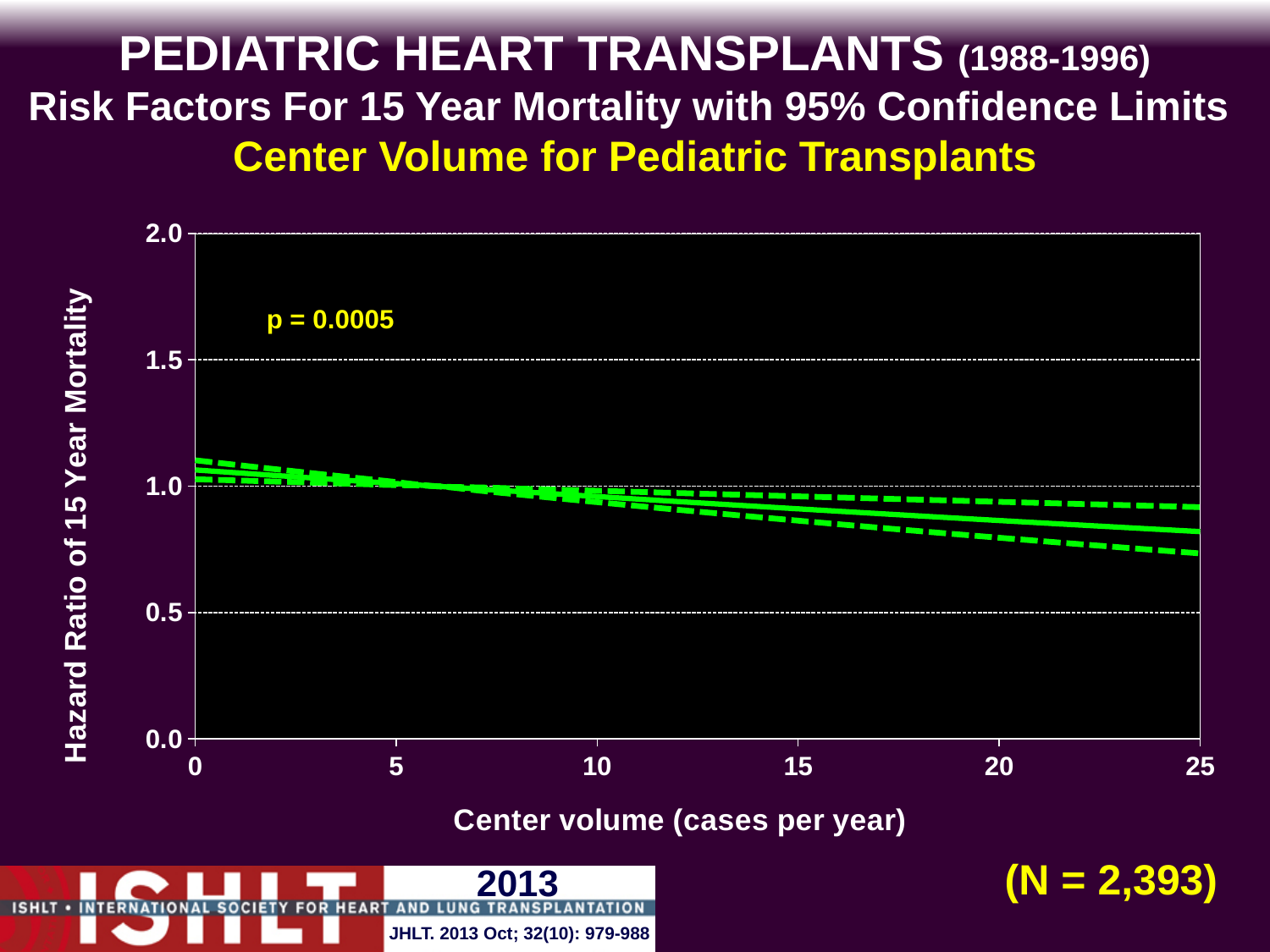
Is the hazard ratio of the solid line at a center volume of 5 cases per year greater or less than 1.5? less Is the hazard ratio of the solid line at a center volume of 0 cases per year greater or less than 1.0? greater Is the hazard ratio of the solid line at a center volume of 20 cases per year greater or less than 0.5? greater Does the hazard ratio rise or fall as center volume increases from 0 to 25 cases per year? fall Is the hazard ratio of the solid line higher at a center volume of 0 or at a center volume of 25 cases per year? 0 What p value is printed on the chart? p = 0.0005 What kind of chart is shown on the slide? line chart How many lines (solid and dashed) are plotted on the chart? 3 What is the label of the y axis? Hazard Ratio of 15 Year Mortality